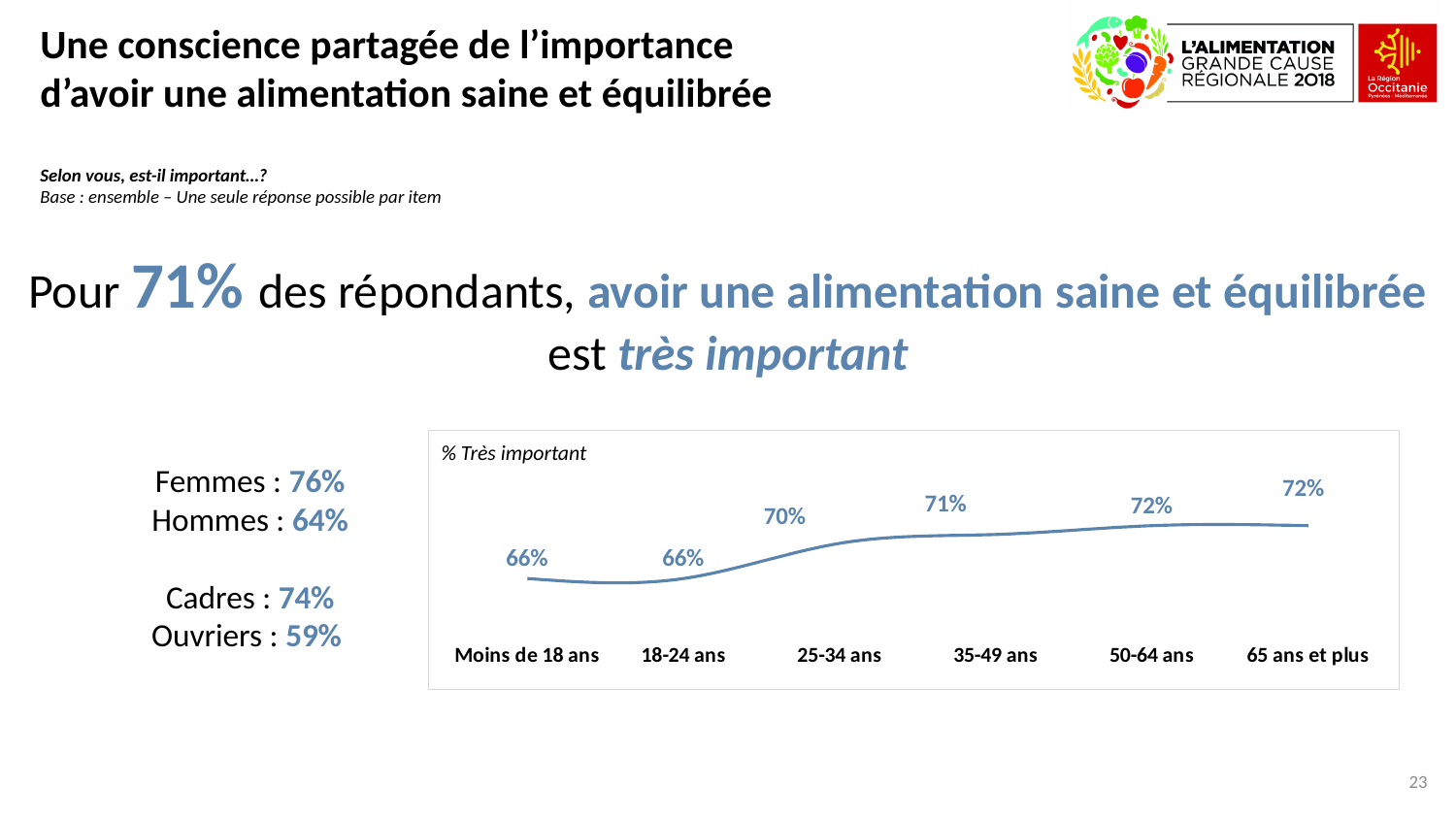
What is the value for the 65 ans et plus category? 72% Is the value for 35-49 ans larger than the value for 25-34 ans? Yes What is the value for the 25-34 ans category? 70% What is the difference between the values for 25-34 ans and 18-24 ans? 4% What is the value for the Moins de 18 ans category? 66% Do the values generally rise or fall from Moins de 18 ans to 65 ans et plus? Rise What is the title shown inside the chart area? % Très important What is the value for the 35-49 ans category? 71% What type of chart is shown on the slide? Line chart Which age category has the lowest value, 18-24 ans or 35-49 ans? 18-24 ans How many age categories are shown on the x axis of the chart? 6 What is the difference between the values for 50-64 ans and Moins de 18 ans? 6%